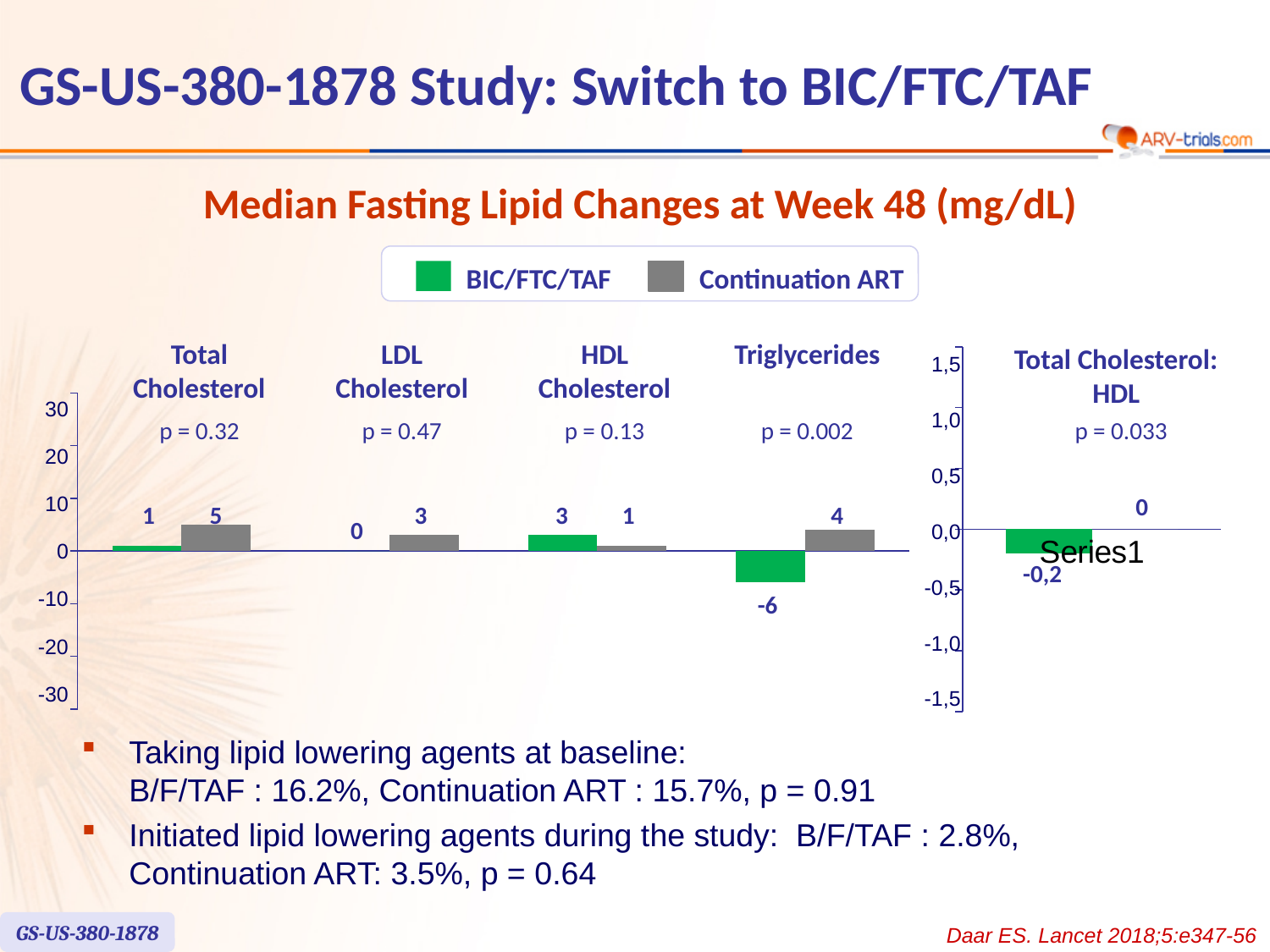
In the main lipid changes chart, which category has the lowest BIC/FTC/TAF value? Triglycerides In the main lipid changes chart, what is the value for BIC/FTC/TAF for Triglycerides? -6 In the main lipid changes chart, which is larger for HDL Cholesterol: BIC/FTC/TAF or Continuation ART? BIC/FTC/TAF How many categories are shown on the x axis of the main lipid changes chart? 4 In the main lipid changes chart, what is the value for Continuation ART for Total Cholesterol? 5 What kind of chart is the main lipid changes chart? Bar chart In the Total Cholesterol: HDL chart on the right, what is the value for BIC/FTC/TAF? -0,2 In the main lipid changes chart, what is the value for BIC/FTC/TAF for LDL Cholesterol? 0 In the main lipid changes chart, which category has the highest Continuation ART value? Total Cholesterol How many series does the legend of the main lipid changes chart list? 2 In the main lipid changes chart, what is the value for Continuation ART for HDL Cholesterol? 1 In the main lipid changes chart, what is the difference between the Continuation ART and BIC/FTC/TAF values for Triglycerides? 10